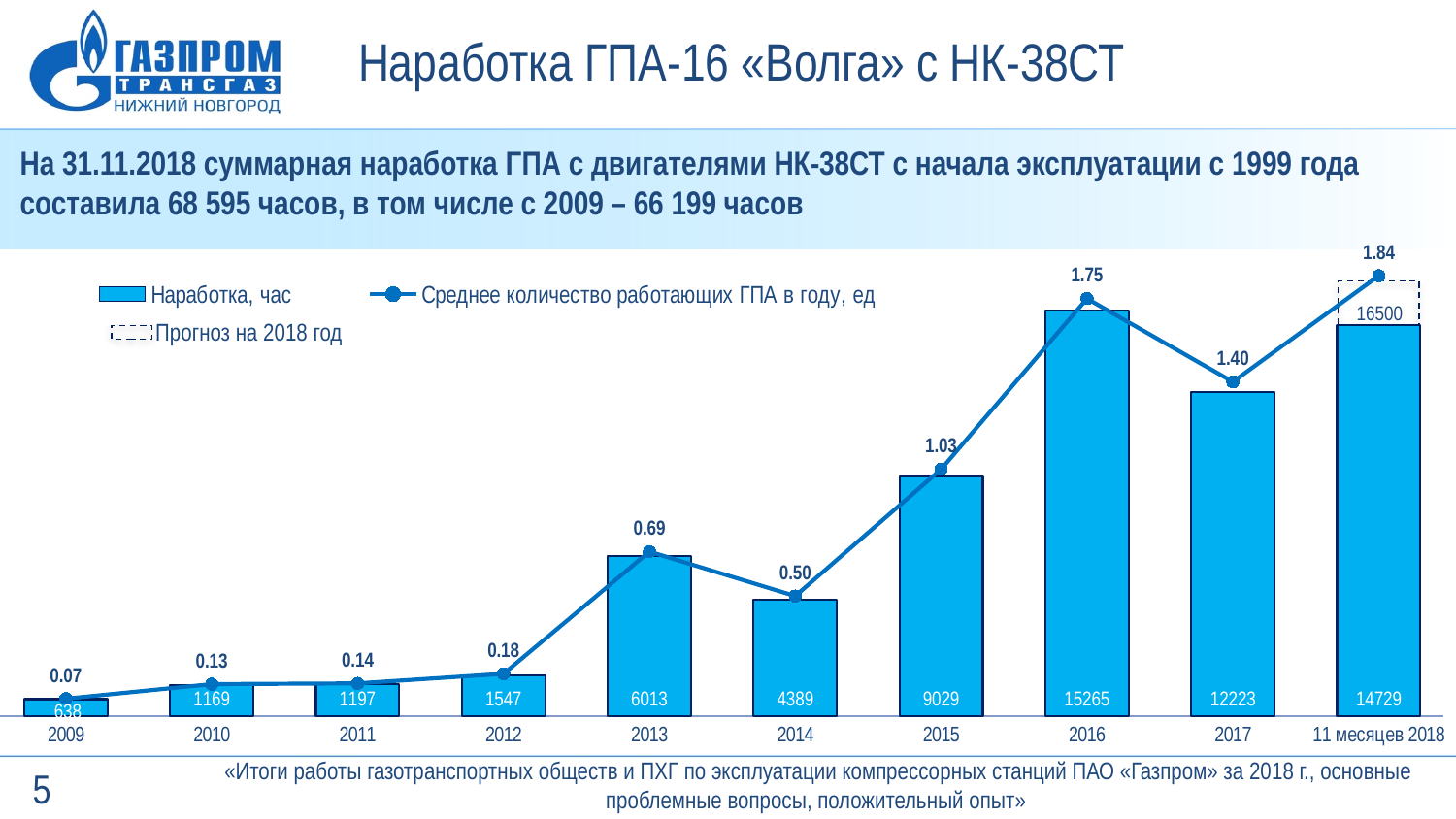
What is the value of Наработка, час for 2016? 15265 How many categories are shown on the x axis? 10 Which is larger, the Наработка, час value for 2013 or for 2014? 2013 Does the value of Среднее количество работающих ГПА в году, ед rise or fall from 2016 to 2017? Fall Which year has the lowest value of Среднее количество работающих ГПА в году, ед? 2009 What is the difference in Наработка, час between 2016 and 2017? 3042 How many entries does the legend list? 3 What kind of chart is shown on the slide? Combined bar and line chart What is the label of the last category on the x axis? 11 месяцев 2018 What is the forecast value (Прогноз на 2018 год) shown for 2018? 16500 What is the value of Среднее количество работающих ГПА в году, ед for 2013? 0.69 Which year has the highest value of Наработка, час among the solid bars? 2016